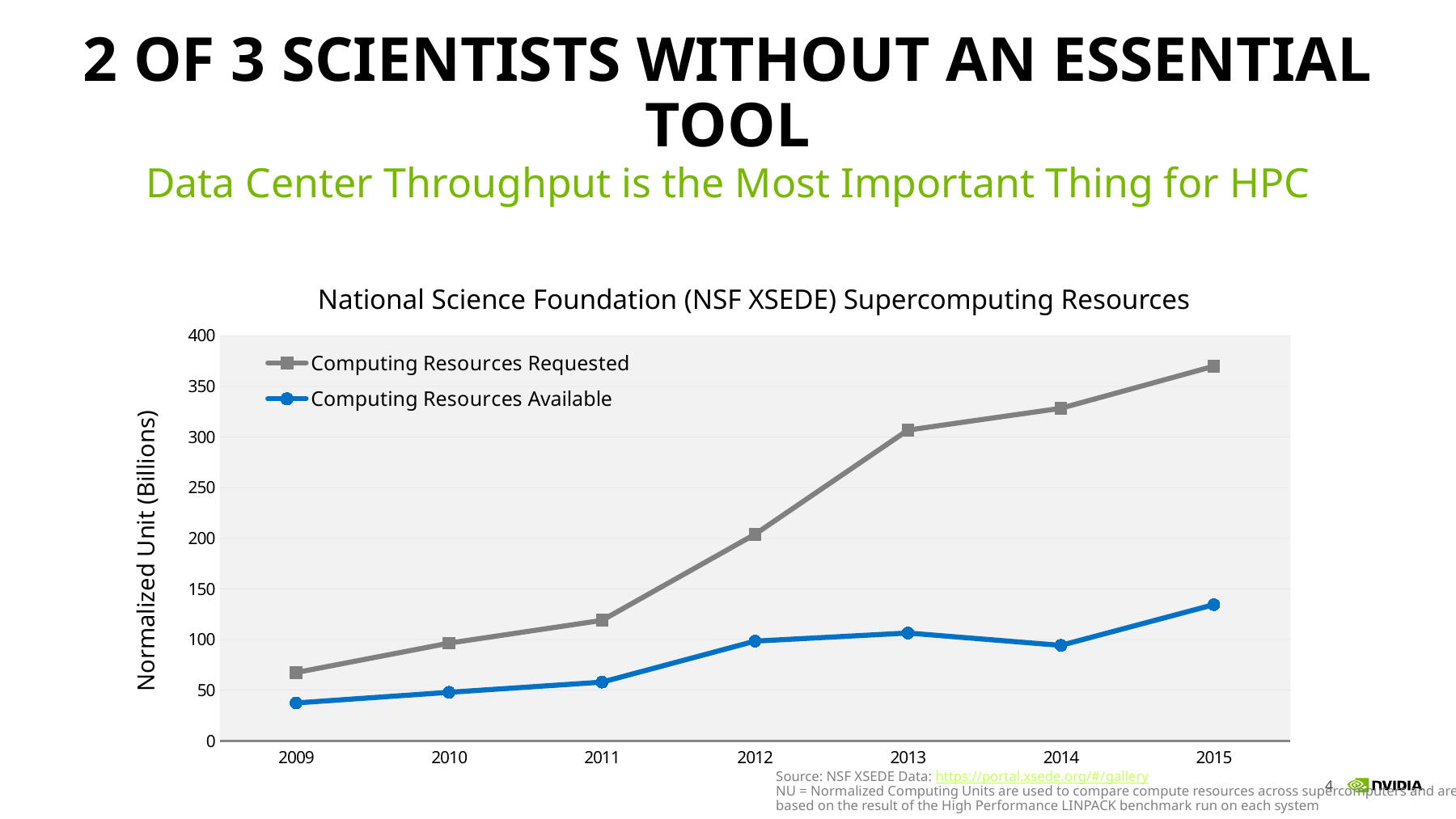
Is the value for Computing Resources Available in 2015 greater or less than 100? greater How many series does the legend list? 2 Is the value for Computing Resources Requested in 2014 greater or less than 350? less In which year is Computing Resources Available lowest? 2009 In 2013, which is larger: Computing Resources Requested or Computing Resources Available? Computing Resources Requested Does Computing Resources Requested rise or fall from 2009 to 2015? rise What is the label on the y axis of the chart? Normalized Unit (Billions) How many years are plotted along the x axis? 7 In which year is Computing Resources Requested highest? 2015 What kind of chart is shown on the slide? line chart Is the value for Computing Resources Available in 2009 greater or less than 50? less